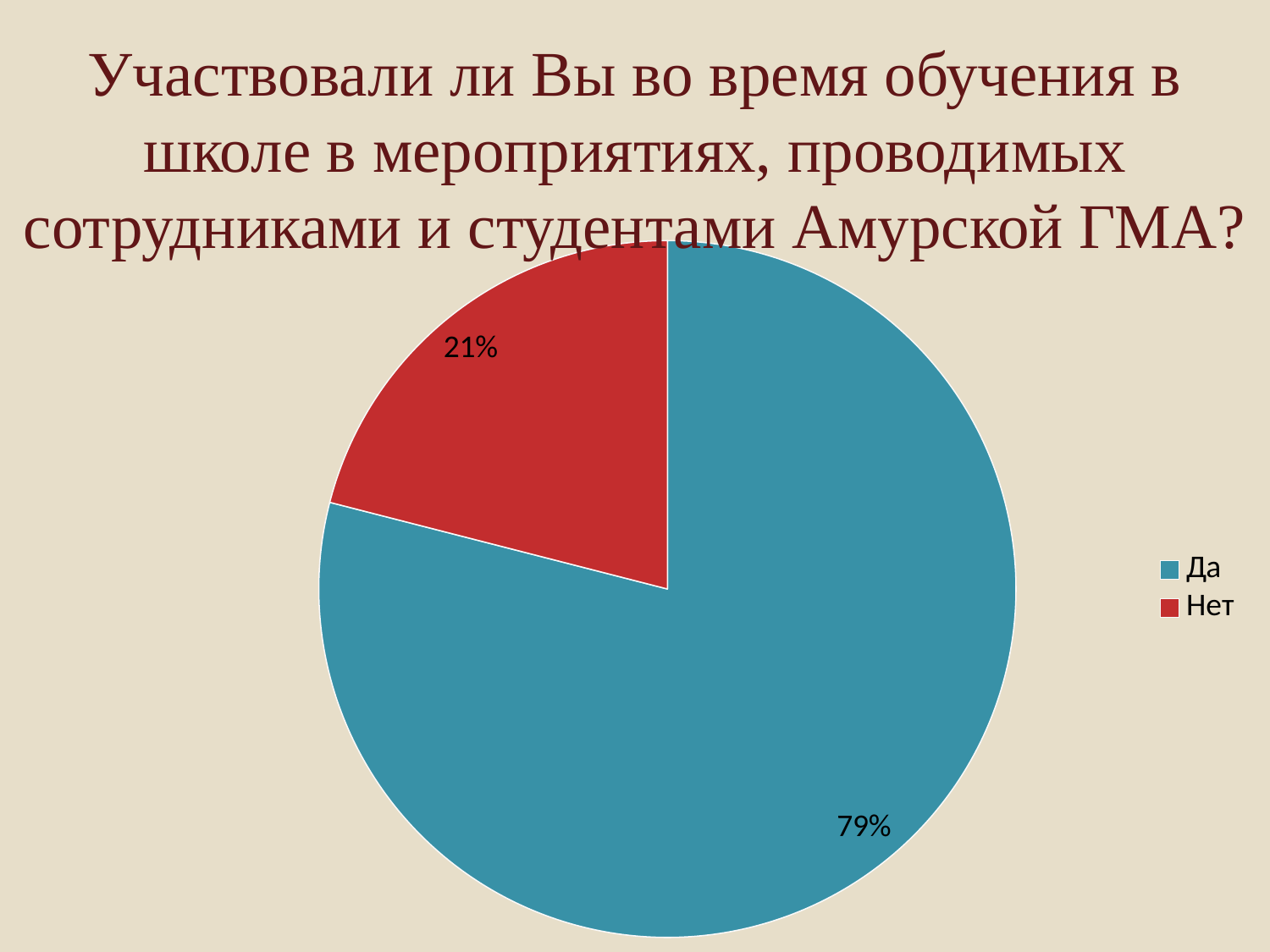
What colour is the "Нет" slice? red What kind of chart is shown on the slide? pie chart How many entries does the legend list? 2 Which is larger, the share for "Да" or the share for "Нет"? Да What share of the pie does the "Да" slice represent? 79% What is the difference in percentage points between the "Да" and "Нет" slices? 58 Which answer has the smallest share of the pie? Нет Which answer has the largest share of the pie? Да What percentage of respondents answered "Нет"? 21% What percentage of respondents answered "Да"? 79% What colour is the "Да" slice? blue How many slices does the pie chart have? 2